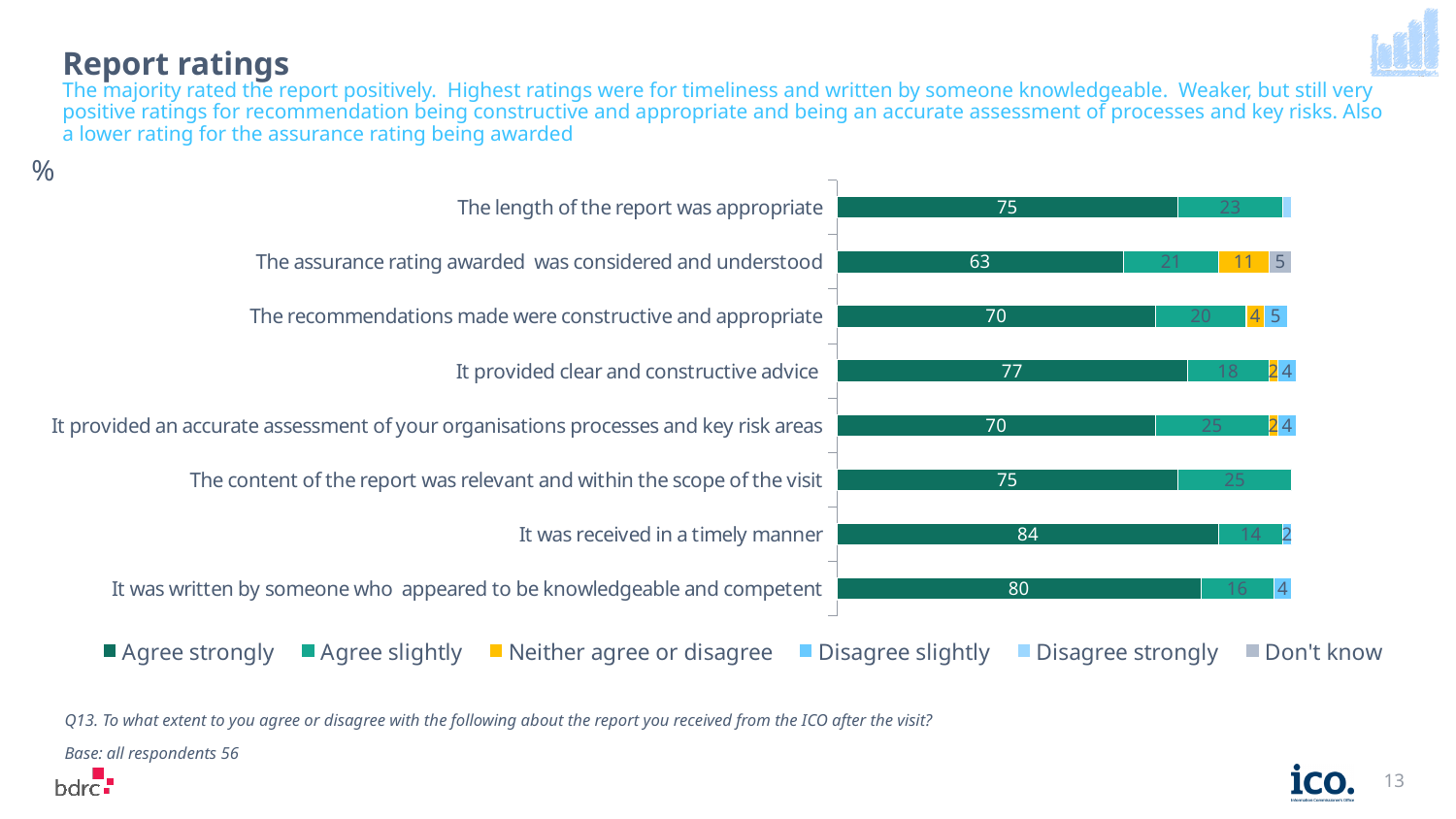
Which has a larger 'Agree strongly' value: 'It provided clear and constructive advice' or 'The recommendations made were constructive and appropriate'? It provided clear and constructive advice What kind of chart is shown on the slide? Stacked bar chart Which statement has the lowest 'Agree strongly' percentage? The assurance rating awarded was considered and understood What is the first entry in the chart's legend? Agree strongly What percentage agreed strongly that the assurance rating awarded was considered and understood? 63 What is the difference between the 'Agree strongly' values for 'It was received in a timely manner' and 'The assurance rating awarded was considered and understood'? 21 How many series does the legend list? 6 What percentage agreed slightly that the report provided an accurate assessment of the organisation's processes and key risk areas? 25 What percentage agreed strongly that the report was received in a timely manner? 84 Which statement has the highest 'Agree strongly' percentage? It was received in a timely manner How many statements (categories) are plotted in the chart? 8 What is the 'Neither agree or disagree' value for 'The assurance rating awarded was considered and understood'? 11